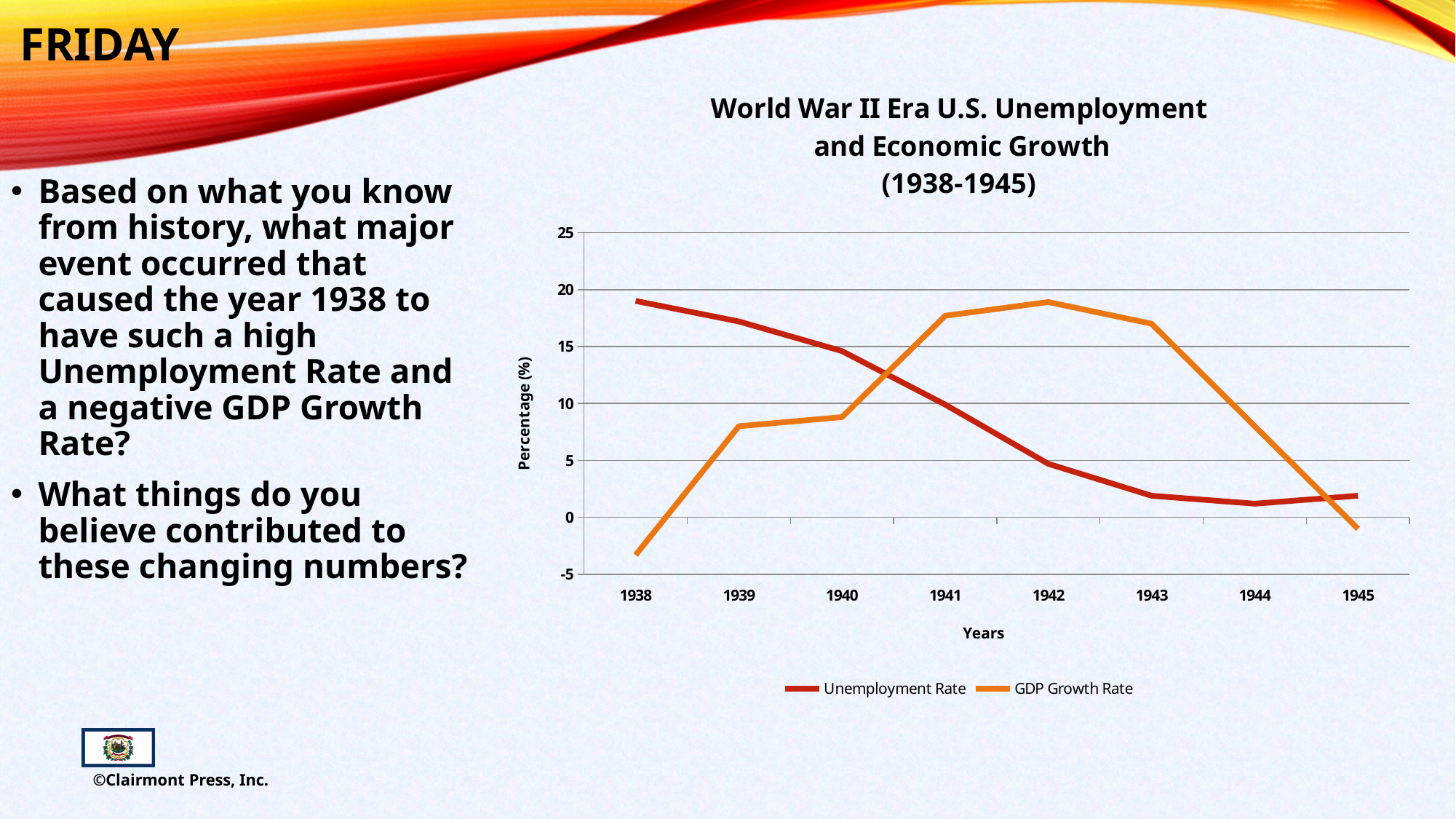
How many series does the legend of the chart list? 2 Is the GDP Growth Rate for 1945 greater or less than 0? less In which year is the GDP Growth Rate highest? 1942 Is the Unemployment Rate for 1938 greater or less than 15? greater In 1940, which is larger: the Unemployment Rate or the GDP Growth Rate? Unemployment Rate In which year is the Unemployment Rate lowest? 1944 In which year is the Unemployment Rate highest? 1938 What is the label on the y axis of the chart? Percentage (%) Does the Unemployment Rate rise or fall from 1938 to 1944? Fall How many years are plotted along the x axis of the chart? 8 In which year is the GDP Growth Rate lowest? 1938 What kind of chart is shown on the slide? Line chart